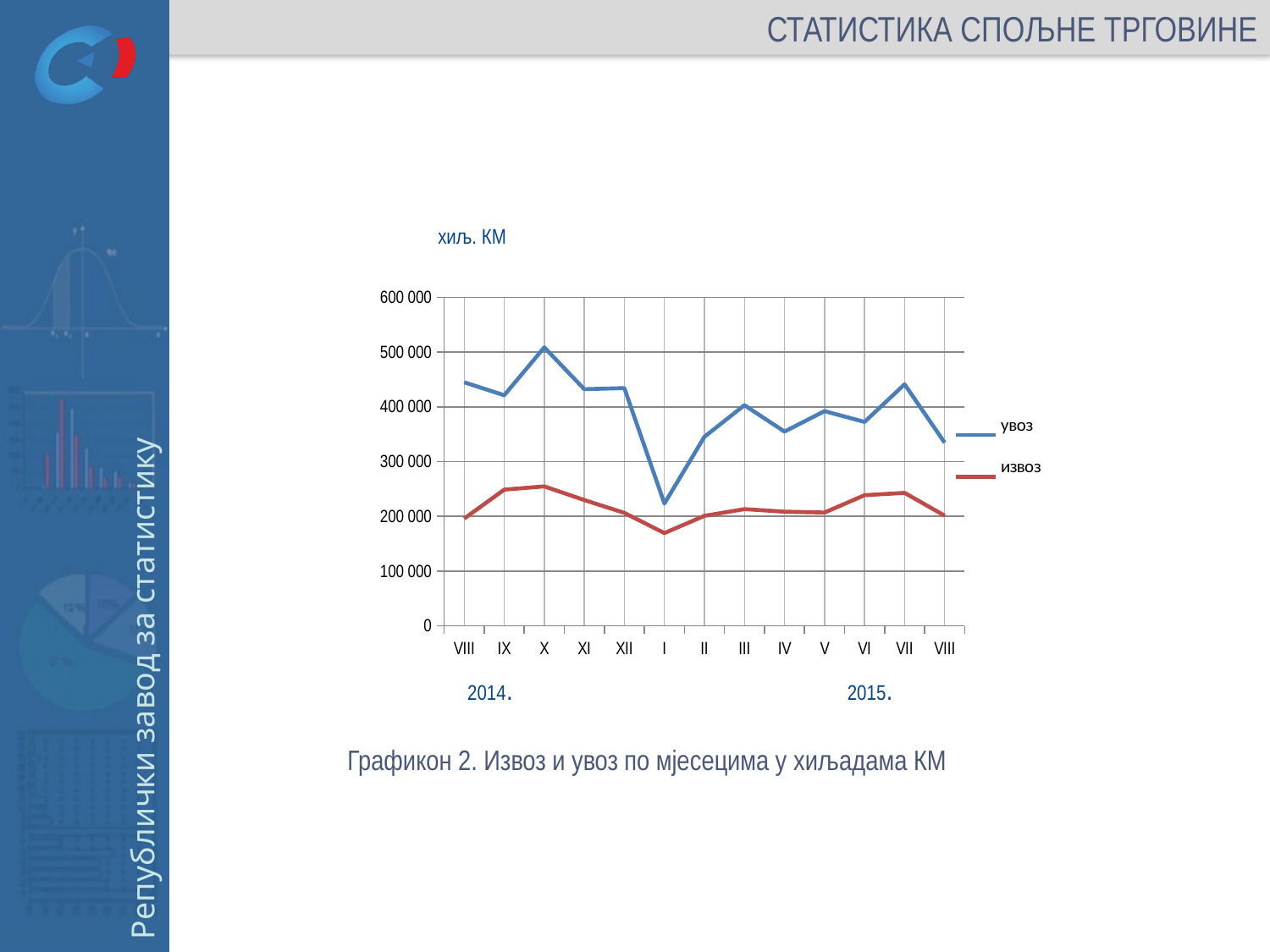
Is the value of увоз in VIII 2014 greater or less than 400 000? greater How many monthly points are plotted along the x axis? 13 Does the увоз series rise or fall from XII 2014 to I 2015? fall How many series does the legend list? 2 What unit label is shown above the y axis of the chart? хиљ. KM In which month is the увоз series at its lowest? I 2015 In which month is the извоз series at its lowest? I 2015 Which series is higher in VII 2015, увоз or извоз? увоз What kind of chart is shown on the slide? line chart Is the value of увоз in I 2015 greater or less than 300 000? less Is the value of извоз in I 2015 greater or less than 200 000? less In which month is the увоз series at its highest? X 2014